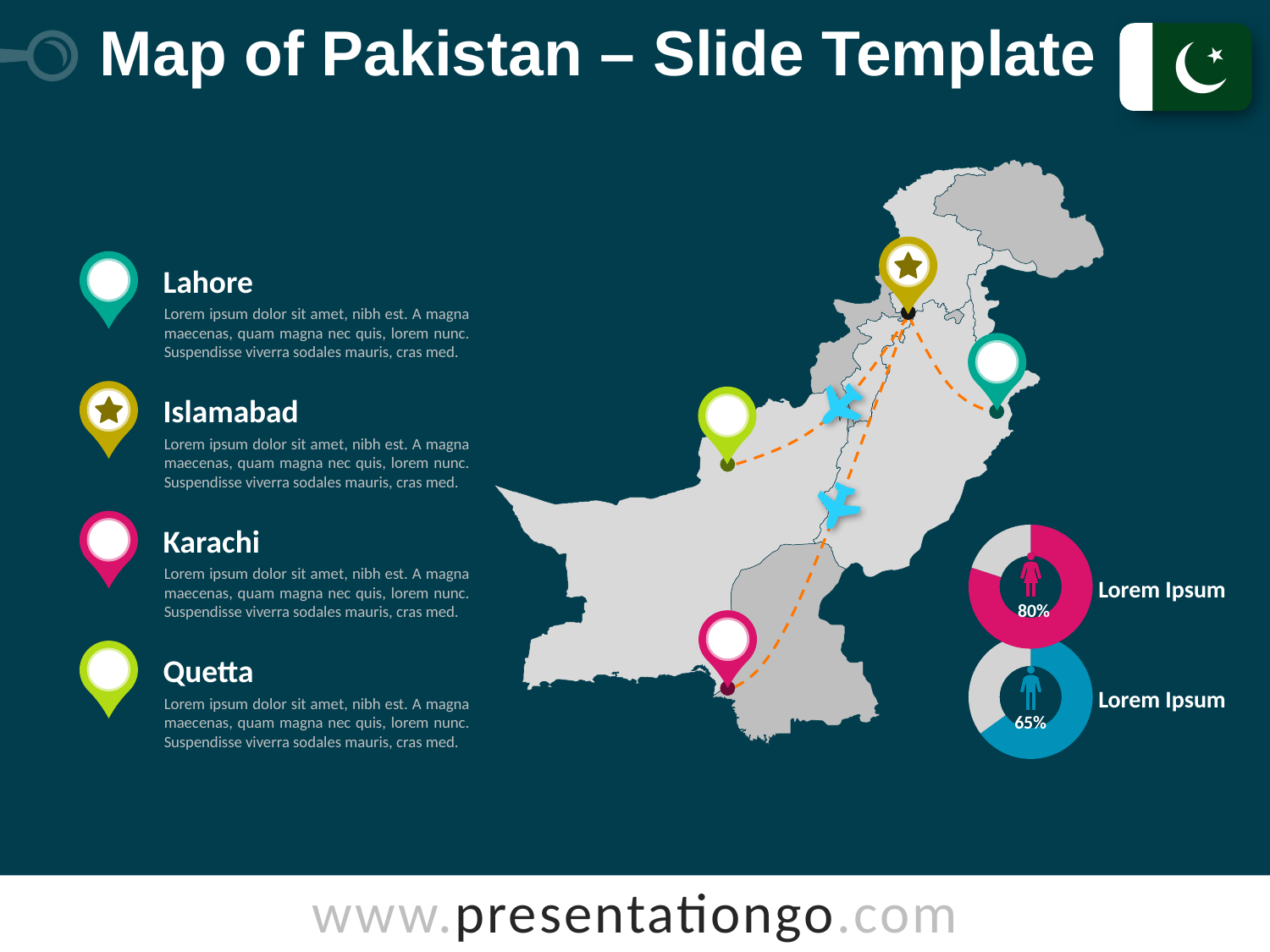
What percentage is shown on the lower (blue) donut chart on the right of the slide? 65% Which of the two donut charts shows the larger percentage, the upper pink one or the lower blue one? The upper pink one (80%) What is the difference between the percentages shown on the upper pink donut chart and the lower blue donut chart? 15 percentage points What percentage is shown on the upper (pink) donut chart on the right of the slide? 80% What icon is shown in the centre of the lower blue donut chart? A male figure What share of the lower donut chart is not filled in blue? 35% What share of the upper donut chart is filled in pink? 80% What label appears next to each of the two donut charts? Lorem Ipsum How many donut charts are shown on the slide? 2 What type of chart is used to display the 80% and 65% values on the slide? Donut (pie) chart